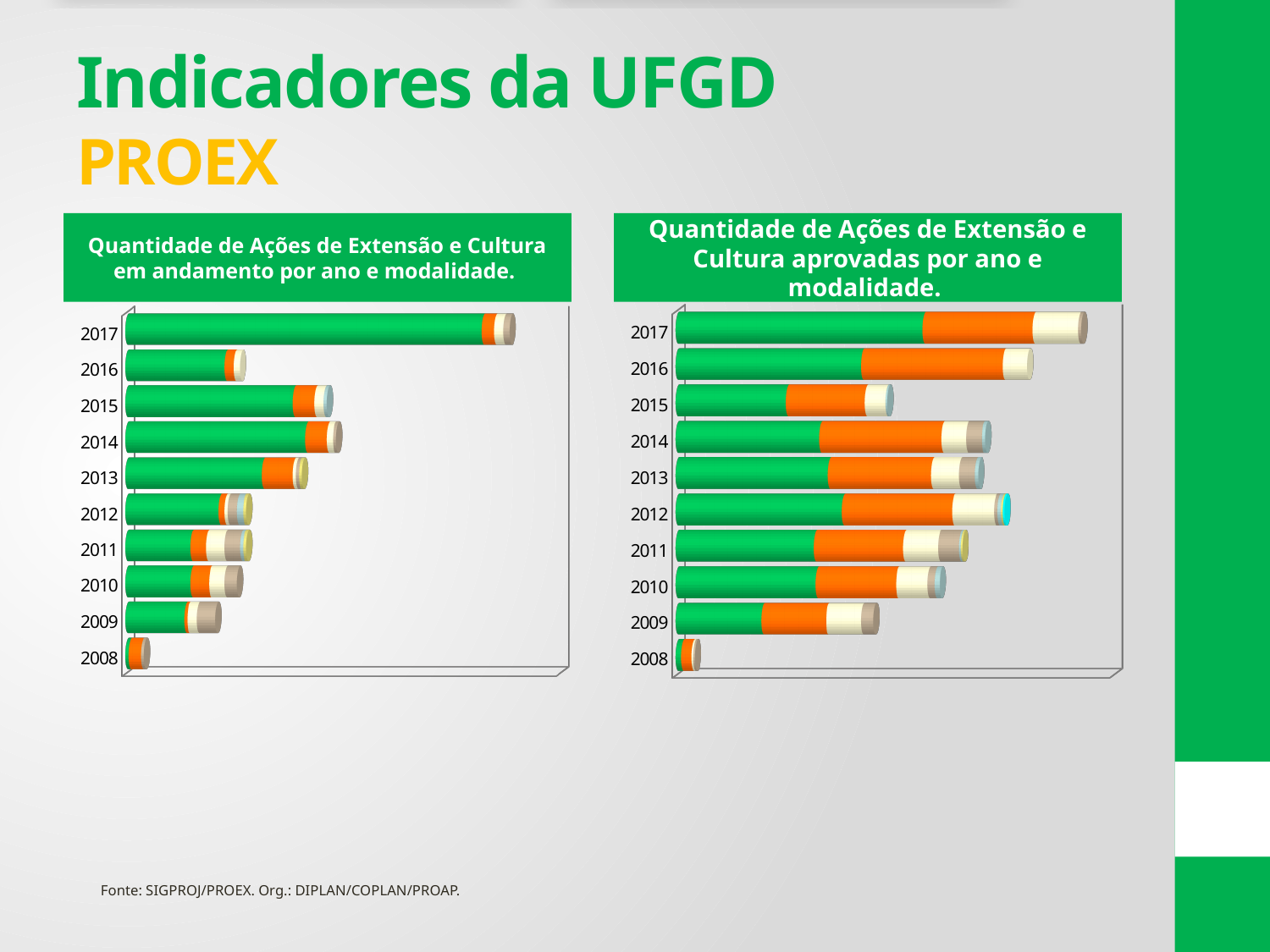
In the right chart, 'Quantidade de Ações de Extensão e Cultura aprovadas por ano e modalidade', which year has the longest total bar? 2017 How many years are shown on the right chart, 'Quantidade de Ações de Extensão e Cultura aprovadas por ano e modalidade'? 10 In the right chart, 'Quantidade de Ações de Extensão e Cultura aprovadas por ano e modalidade', which year has the longer total bar, 2009 or 2010? 2010 What kind of chart is the right chart, 'Quantidade de Ações de Extensão e Cultura aprovadas por ano e modalidade'? Stacked bar chart In the left chart, 'Quantidade de Ações de Extensão e Cultura em andamento por ano e modalidade', which year has the longest total bar? 2017 How many years are shown on the left chart, 'Quantidade de Ações de Extensão e Cultura em andamento por ano e modalidade'? 10 What is the title of the left chart on the slide? Quantidade de Ações de Extensão e Cultura em andamento por ano e modalidade. What kind of chart is the left chart, 'Quantidade de Ações de Extensão e Cultura em andamento por ano e modalidade'? Stacked bar chart In the left chart, 'Quantidade de Ações de Extensão e Cultura em andamento por ano e modalidade', which year has the longer total bar, 2014 or 2016? 2014 In the left chart, 'Quantidade de Ações de Extensão e Cultura em andamento por ano e modalidade', which year has the shortest total bar? 2008 In the right chart, 'Quantidade de Ações de Extensão e Cultura aprovadas por ano e modalidade', which year has the longer total bar, 2015 or 2016? 2016 In the right chart, 'Quantidade de Ações de Extensão e Cultura aprovadas por ano e modalidade', which year has the shortest total bar? 2008